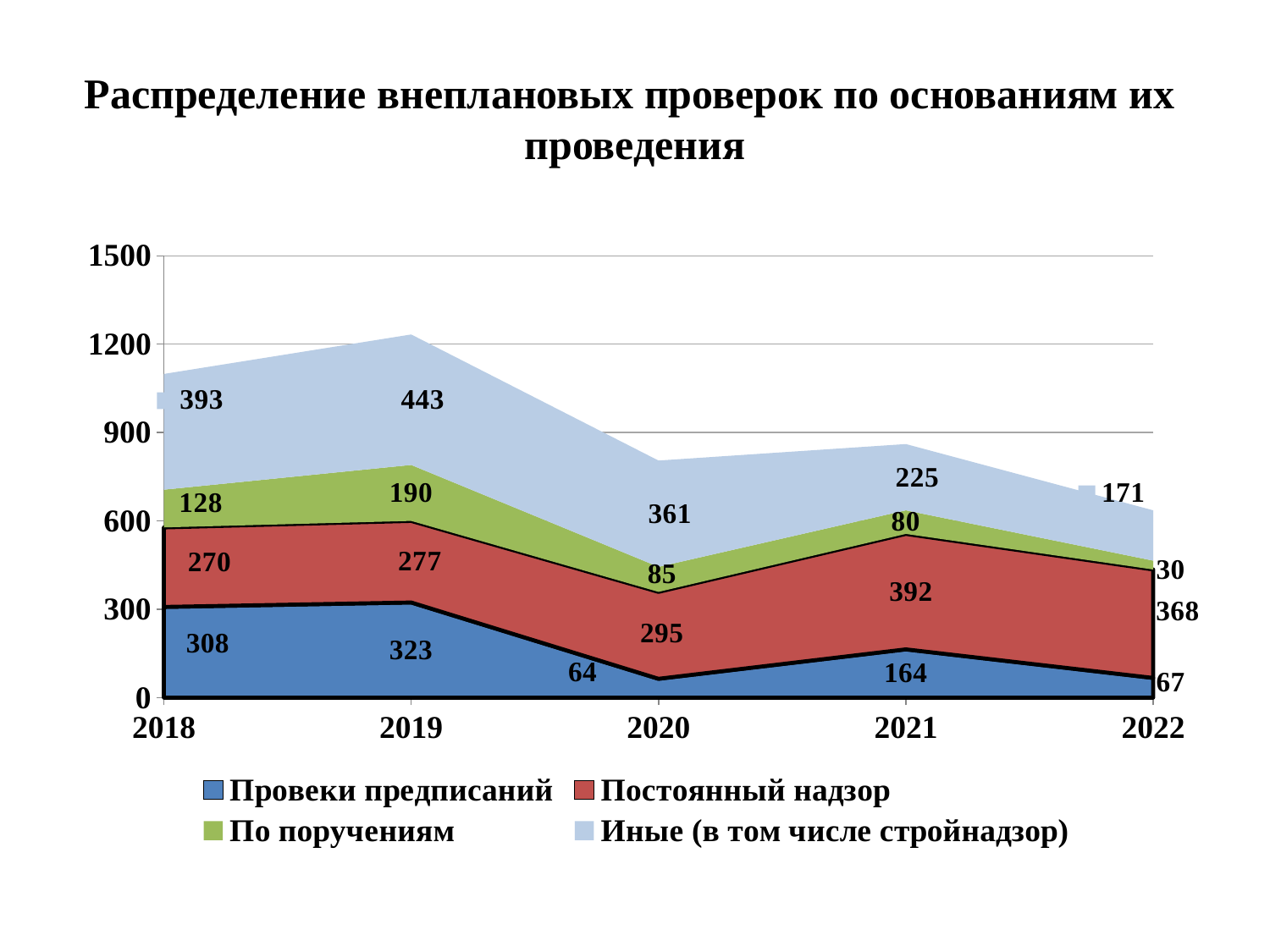
How many years are shown on the x axis? 5 What is the difference between the Провеки предписаний values in 2019 and 2020? 259 In which year is the value for Иные (в том числе стройнадзор) lowest? 2022 What is the value for Постоянный надзор in 2021? 392 What is the value for Иные (в том числе стройнадзор) in 2019? 443 How many series does the legend list? 4 What kind of chart is shown on the slide? Stacked area chart Which is larger in 2020: Постоянный надзор or Иные (в том числе стройнадзор)? Иные (в том числе стройнадзор) What is the value for По поручениям in 2022? 30 What is the total of all four series in 2022? 636 Does the value for Иные (в том числе стройнадзор) rise or fall from 2019 to 2022? Fall In which year is the value for Провеки предписаний highest? 2019